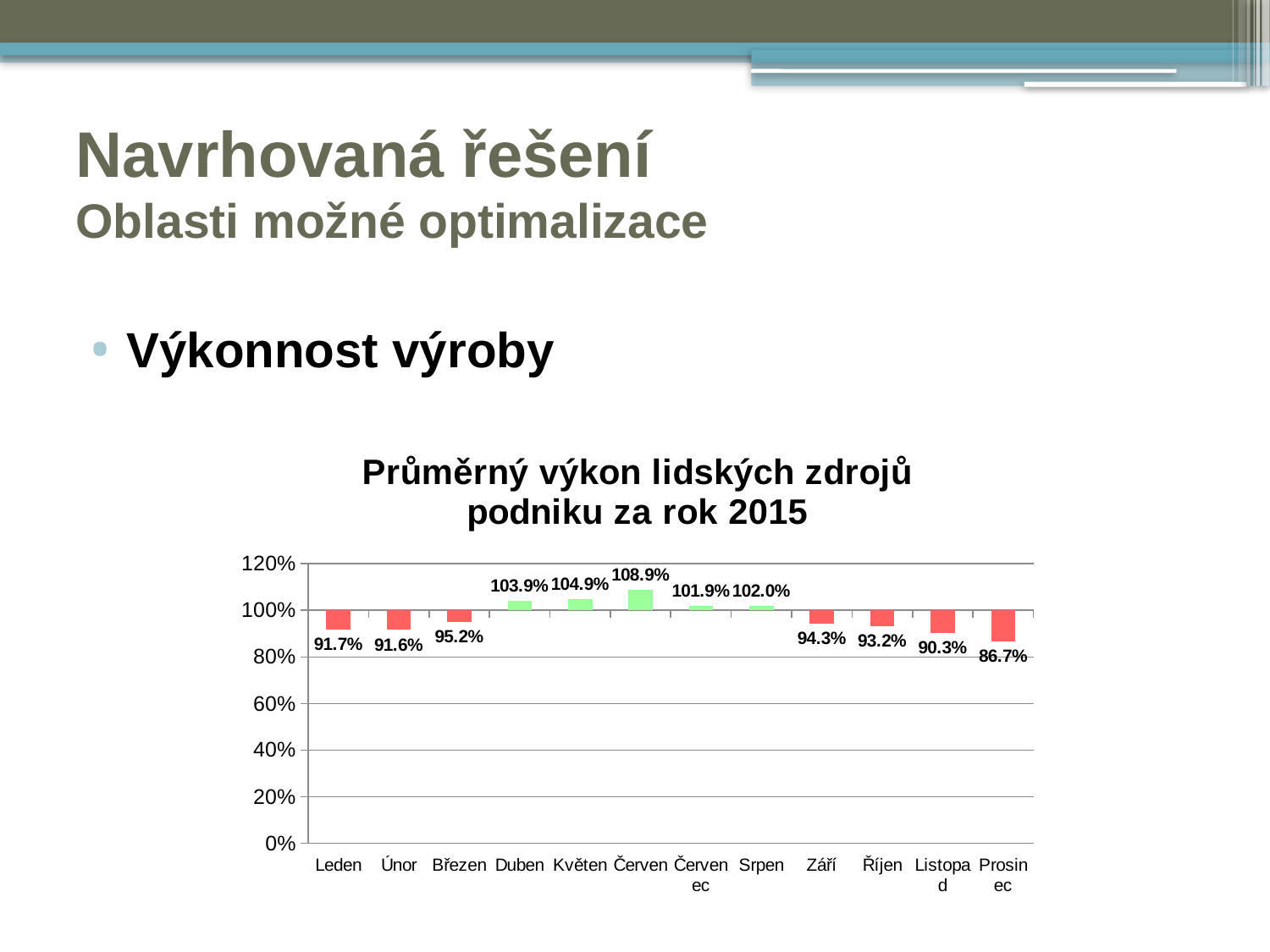
What is the value for Leden? 91.7% Is the value for Září greater or less than 100%? less What is the value for Listopad? 90.3% Which is larger, the value for Duben or the value for Květen? Květen How many months are shown on the x axis? 12 Do the values rise or fall from Září to Prosinec? fall What kind of chart is shown on the slide? bar chart Which month has the lowest value? Prosinec What is the title of the chart? Průměrný výkon lidských zdrojů podniku za rok 2015 Which month has the highest value? Červen What is the value for Červen? 108.9% What is the difference between the values for Červen and Prosinec? 22.2 percentage points